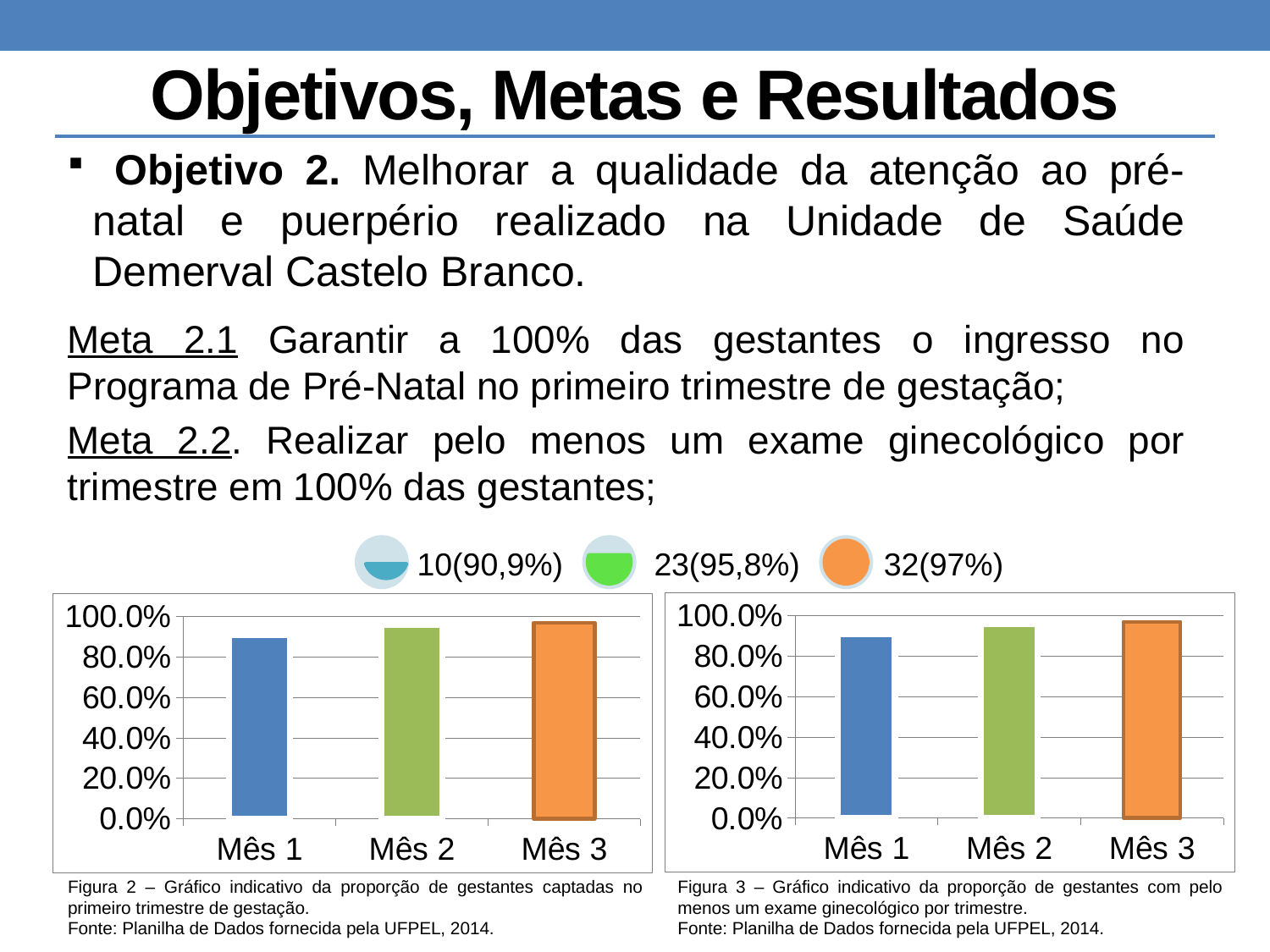
In the left chart (Figura 2), which month has the lowest bar? Mês 1 In the left chart (Figura 2), is the value for Mês 1 greater or less than 80.0%? greater How many entries does the legend above the charts list? 3 How many categories are shown on the x axis of the right chart (Figura 3)? 3 In the left chart (Figura 2), what colour is the bar for Mês 1? blue What kind of chart is the left chart (Figura 2)? bar chart In the right chart (Figura 3), is the value for Mês 3 greater or less than 100.0%? less In the right chart (Figura 3), which month has the lowest bar? Mês 1 In the left chart (Figura 2), do the values rise or fall from Mês 1 to Mês 3? rise In the right chart (Figura 3), do the values rise or fall from Mês 1 to Mês 3? rise In the left chart (Figura 2), is the value for Mês 2 greater or less than 60.0%? greater In the right chart (Figura 3), which is larger, the value for Mês 1 or the value for Mês 2? Mês 2